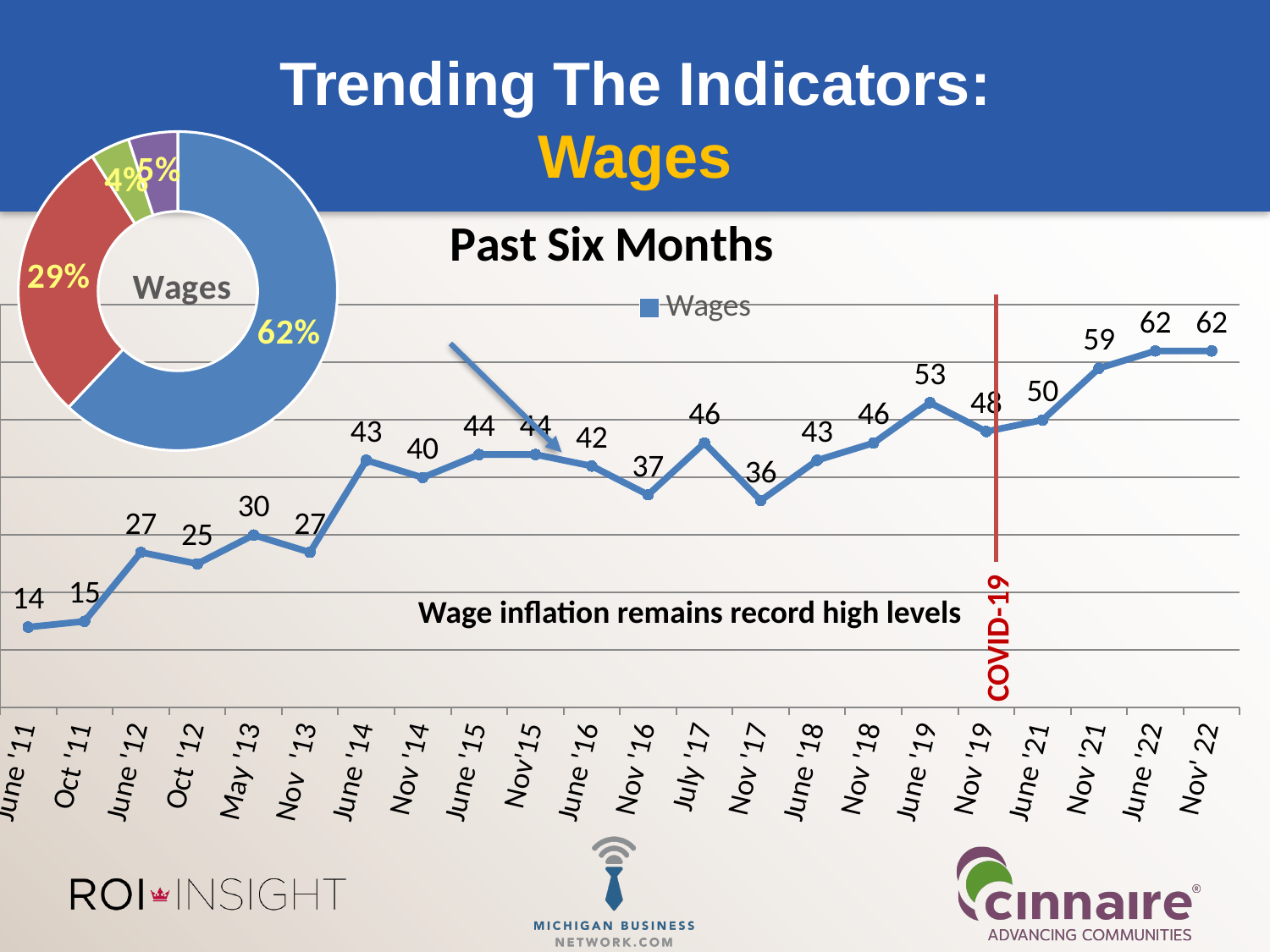
In the line chart titled 'Past Six Months', do the values generally rise or fall from June '11 to Nov '22? rise In the line chart titled 'Past Six Months', how many series does the legend list? 1 In the line chart titled 'Past Six Months', what is the highest value shown? 62 In the line chart titled 'Past Six Months', how many data points are plotted? 22 In the line chart titled 'Past Six Months', what is the value for June '19? 53 In the line chart titled 'Past Six Months', which point has the lowest value? June '11 In the line chart titled 'Past Six Months', which is larger, the value for July '17 or the value for Nov '16? July '17 What kind of chart is the chart in the top-left corner of the slide labelled 'Wages'? doughnut chart In the line chart titled 'Past Six Months', what is the value for Nov '17? 36 In the doughnut chart labelled 'Wages' in the top-left corner, what is the percentage of the largest slice? 62% In the line chart titled 'Past Six Months', what is the value for June '11? 14 In the line chart titled 'Past Six Months', what is the difference between the values for Nov '21 and Nov '19? 11